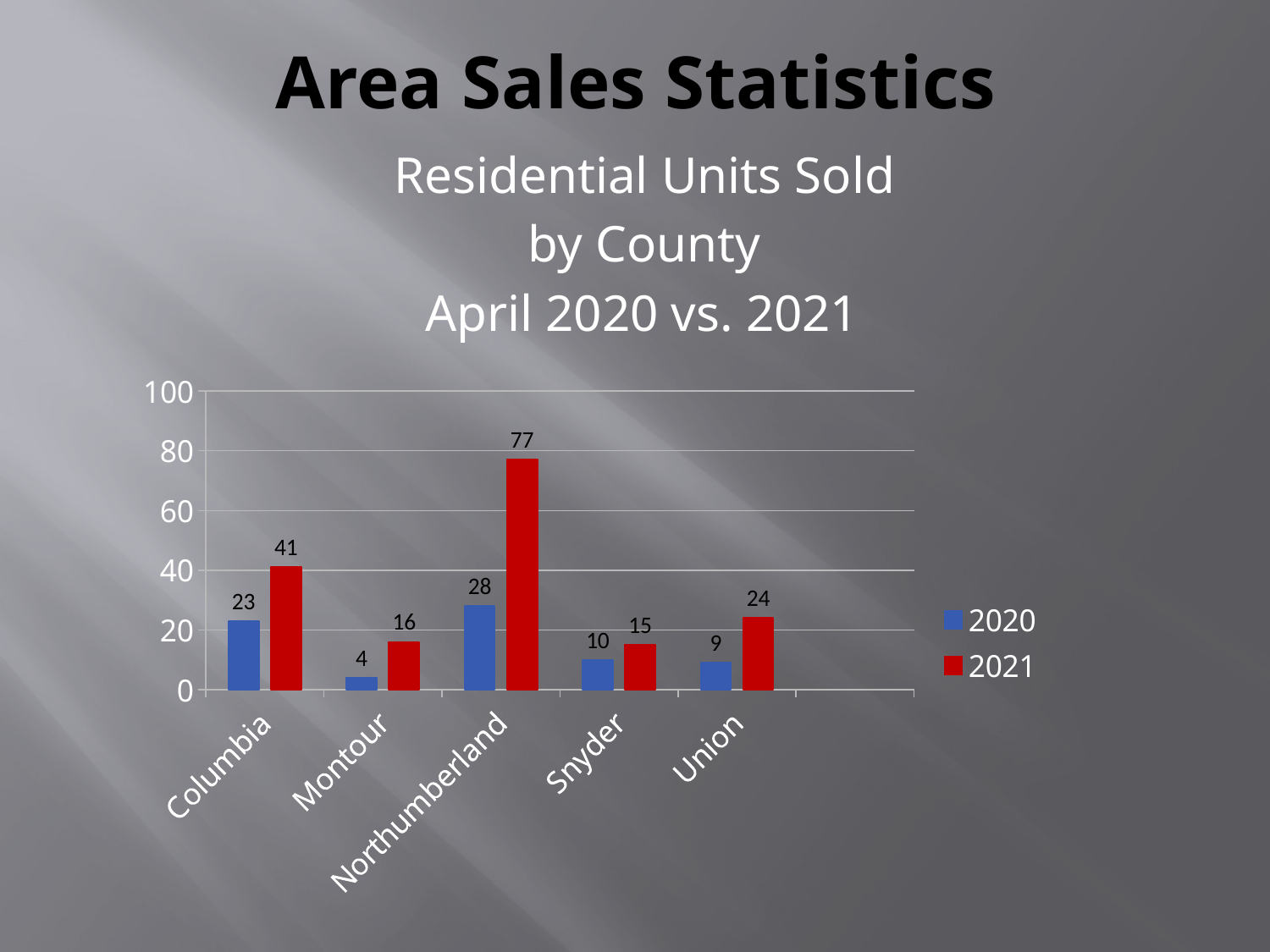
Which county had the highest number of units sold in 2021? Northumberland How many residential units were sold in Montour in 2020? 4 What was the number of residential units sold in Northumberland in 2021? 77 What kind of chart is shown on the slide? bar chart Is the 2021 value for Northumberland greater or less than 60? greater What is the 2021 value for Union? 24 How many series does the legend list? 2 Which county had the lowest number of units sold in 2020? Montour Which colour represents the 2021 series in the legend? red Which is larger: the 2020 value for Snyder or the 2020 value for Union? Snyder How many counties are shown on the x axis? 5 What is the difference between the 2021 and 2020 values for Columbia? 18